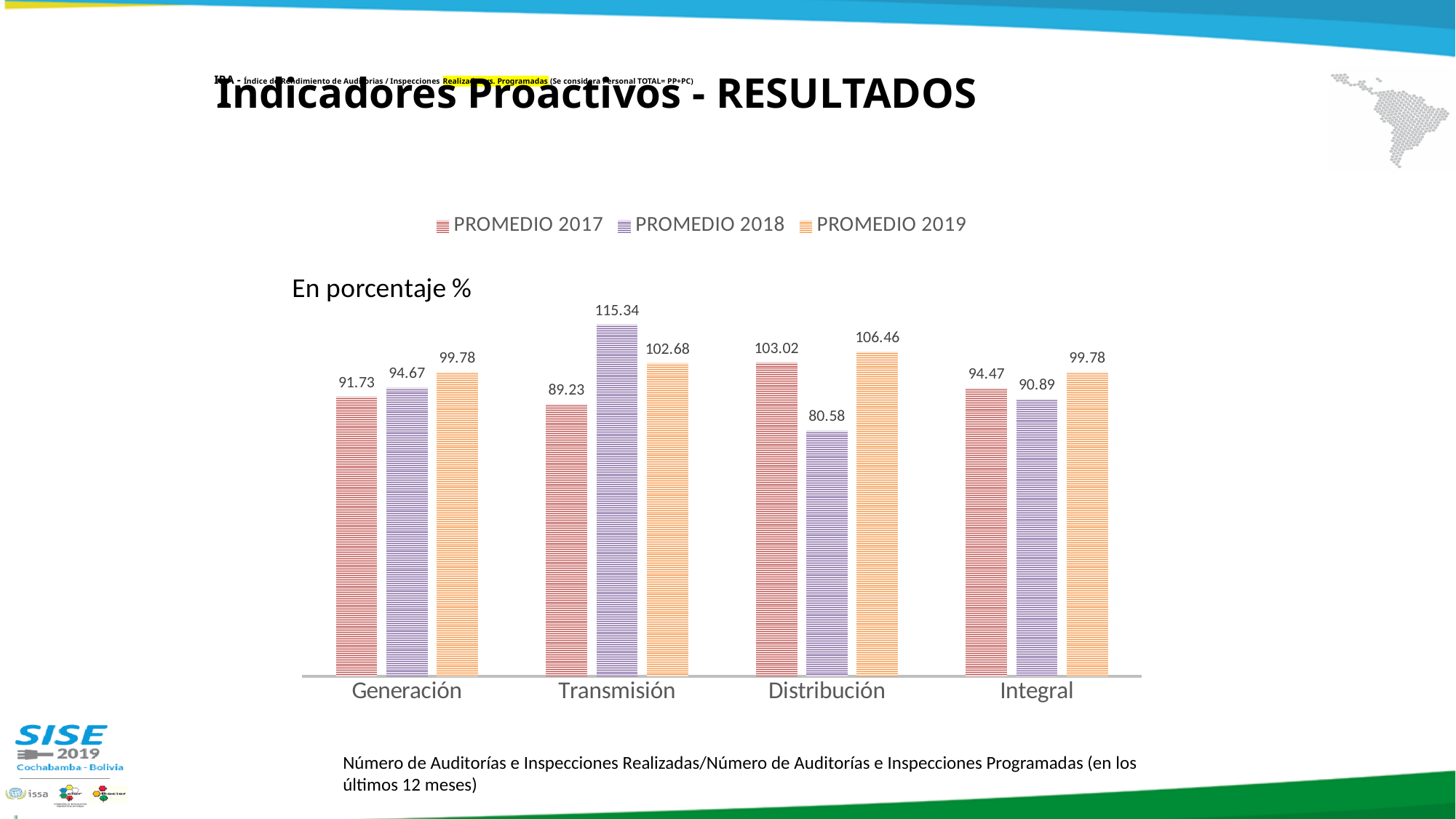
Which category has the lowest PROMEDIO 2017 value? Transmisión What unit label is shown above the chart? En porcentaje % What is the difference between the PROMEDIO 2019 and PROMEDIO 2017 values for Generación? 8.05 How many categories are shown on the x axis? 4 What is the PROMEDIO 2019 value for Integral? 99.78 What kind of chart is shown on the slide? Bar chart How many series does the legend list? 3 Which is larger for Integral: the PROMEDIO 2017 value or the PROMEDIO 2018 value? PROMEDIO 2017 Which category has the highest PROMEDIO 2019 value? Distribución What is the PROMEDIO 2018 value for Transmisión? 115.34 What is the PROMEDIO 2018 value for Distribución? 80.58 What is the PROMEDIO 2017 value for Distribución? 103.02